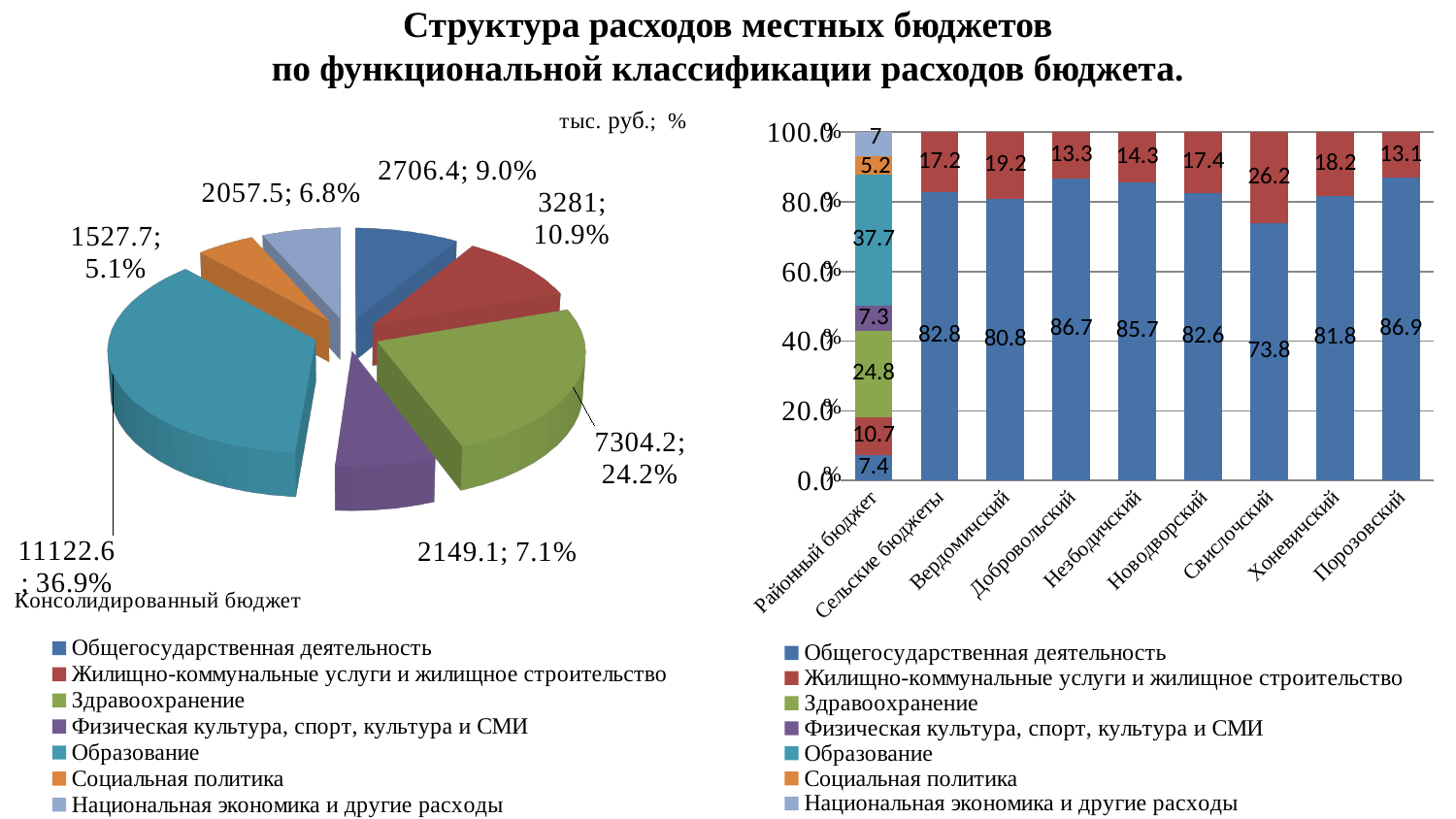
In the stacked bar chart on the right, what is the value of Жилищно-коммунальные услуги и жилищное строительство for Порозовский? 13.1 In the pie chart on the left, which category has the largest slice? Образование In the stacked bar chart on the right, what is the difference between the Общегосударственная деятельность values for Добровольский and Вердомичский? 5.9 In the pie chart on the left, what value is shown for the Образование slice? 11122.6; 36.9% In the pie chart on the left, how many slices are there? 7 In the stacked bar chart on the right, which category has the highest value for Общегосударственная деятельность? Порозовский How many series does the legend of the chart on the right list? 7 In the stacked bar chart on the right, what is the value of Общегосударственная деятельность for Свислочский? 73.8 In the stacked bar chart on the right, what is the value of Образование for Районный бюджет? 37.7 In the pie chart on the left, which category has the smallest slice? Социальная политика In the stacked bar chart on the right, how many categories are shown on the x axis? 9 In the pie chart on the left, what share of the pie does Здравоохранение take? 24.2%